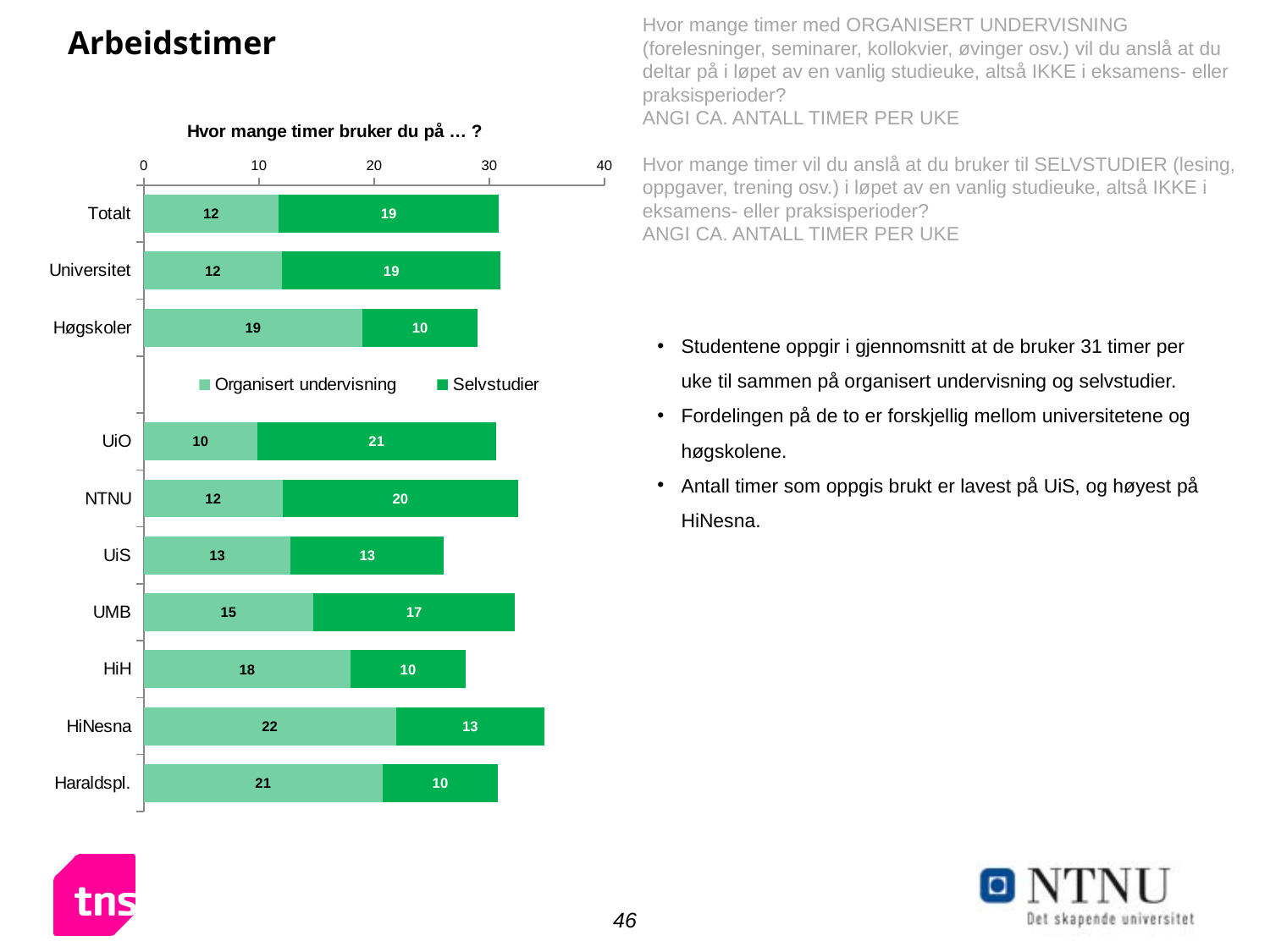
What is the value for Organisert undervisning for HiNesna? 22 Which category has the highest value for Organisert undervisning? HiNesna What is the total of the stacked bar for HiNesna? 35 Which category has the highest value for Selvstudier? UiO What is the value for Selvstudier for NTNU? 20 How many series does the chart legend list? 2 What type of chart is shown on the slide? Stacked bar chart What is the title of the chart? Hvor mange timer bruker du på … ? Which category has the lowest value for Organisert undervisning? UiO What is the difference between the Selvstudier values for UiO and UiS? 8 Which is larger: the Organisert undervisning value for Høgskoler or for Universitet? Høgskoler How many categories are plotted in the chart? 10